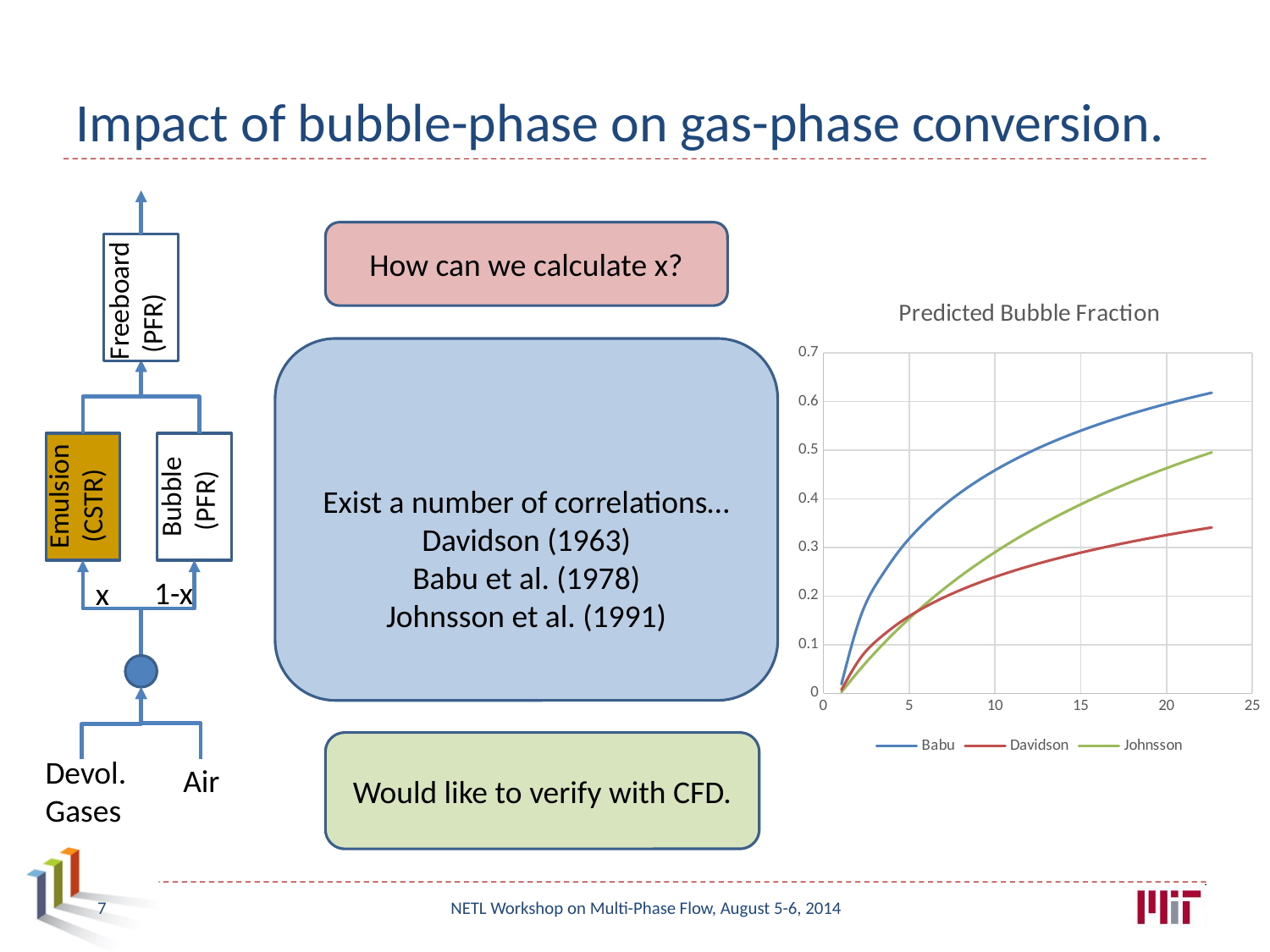
In the "Predicted Bubble Fraction" chart, at x = 20, is the Babu value larger or the Davidson value larger? Babu What is the title of the chart on the slide? Predicted Bubble Fraction In the "Predicted Bubble Fraction" chart, is the Davidson value at x = 20 greater or less than 0.4? less In the "Predicted Bubble Fraction" chart, which series has the highest value at the right end of the x axis? Babu In the "Predicted Bubble Fraction" chart, is the Babu value at x = 10 greater or less than 0.4? greater In the "Predicted Bubble Fraction" chart, which series has the lowest value at the right end of the x axis? Davidson In the "Predicted Bubble Fraction" chart, do the values of the Babu series rise or fall as x increases? rise In the "Predicted Bubble Fraction" chart, is the Johnsson value at x = 20 greater or less than 0.4? greater What kind of chart is the "Predicted Bubble Fraction" chart? line chart What is the highest value shown on the y axis of the "Predicted Bubble Fraction" chart? 0.7 How many series does the legend of the "Predicted Bubble Fraction" chart list? 3 What are the names of the series in the legend of the "Predicted Bubble Fraction" chart? Babu, Davidson, Johnsson